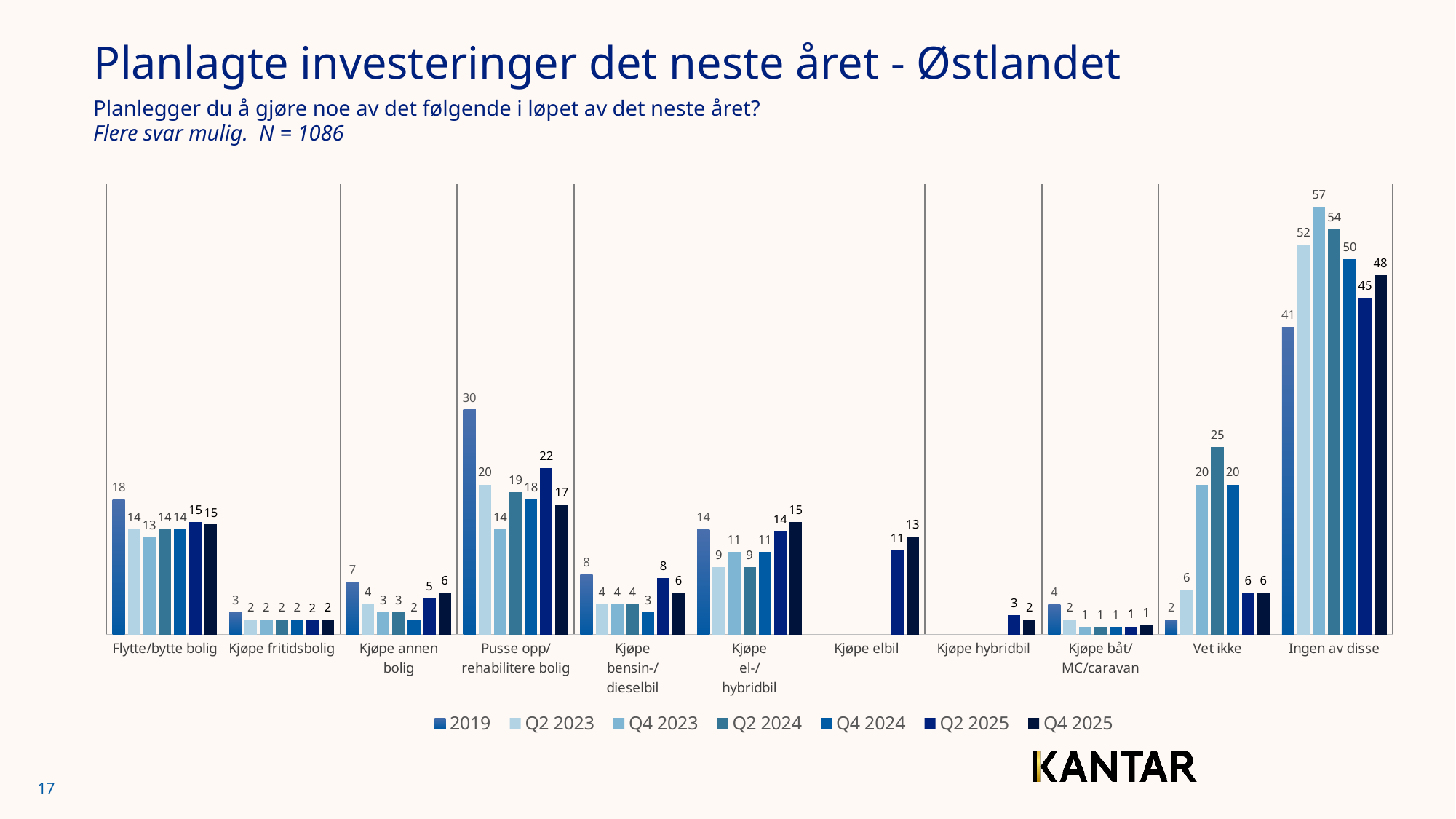
How many series does the legend list? 7 Which is larger for Flytte/bytte bolig: the 2019 value or the Q4 2025 value? 2019 What is the Q2 2024 value for Vet ikke? 25 What is the Q4 2025 value for Kjøpe elbil? 13 What is the difference between the Q4 2023 and 2019 values for Ingen av disse? 16 What kind of chart is shown on the slide? Bar chart Which category has the highest Q4 2023 value? Ingen av disse How many categories are shown on the x axis? 11 Which series has the lowest value for Ingen av disse? 2019 What is the 2019 value for Pusse opp/rehabilitere bolig? 30 What is the difference between the Q2 2025 and Q4 2025 values for Pusse opp/rehabilitere bolig? 5 What is the Q4 2025 value for Ingen av disse? 48